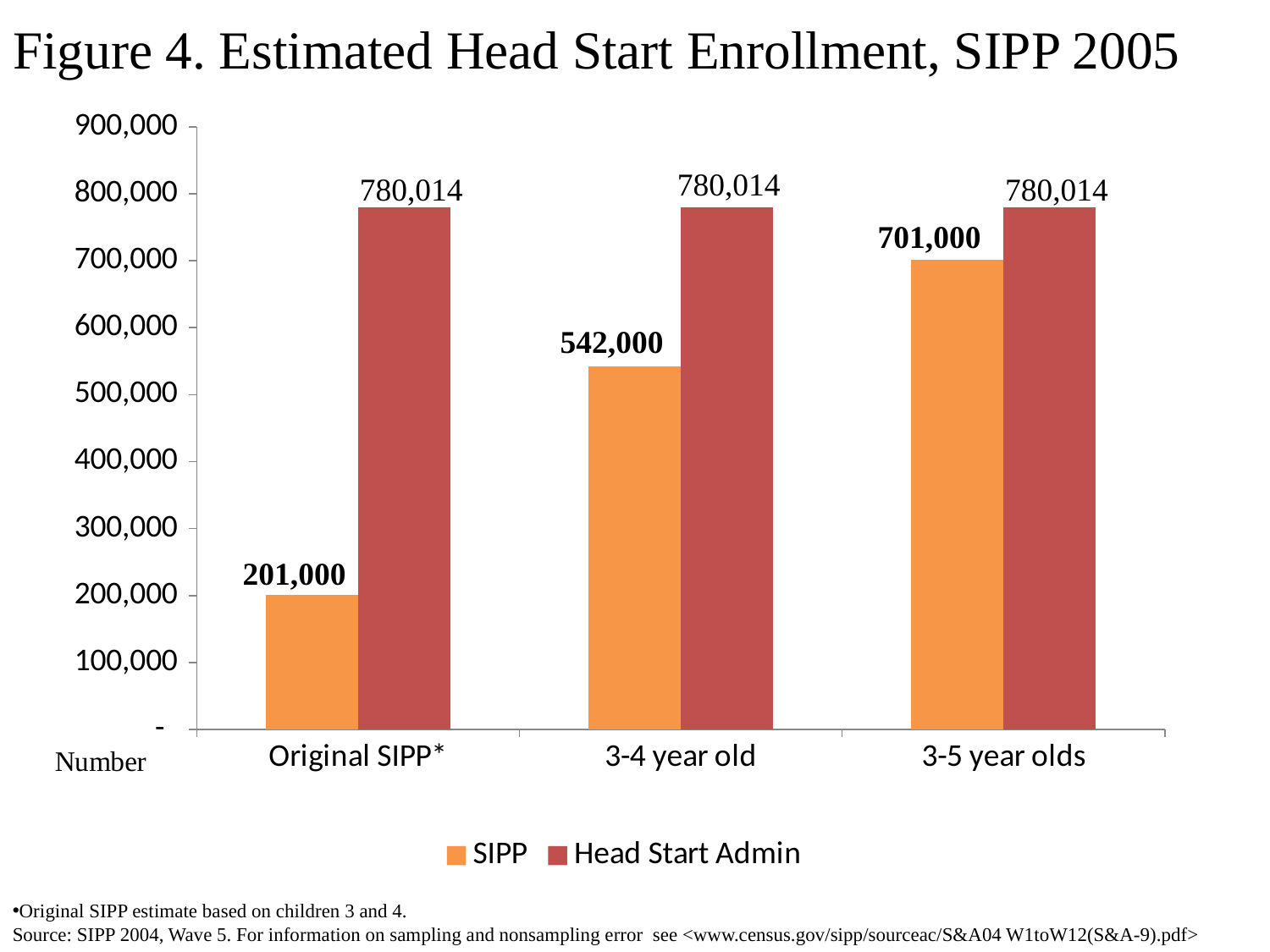
What is the SIPP value for 3-5 year olds? 701,000 What kind of chart is shown on the slide? Bar chart What is the difference between the Head Start Admin value and the SIPP value for 3-5 year olds? 79,014 Which category has the lowest SIPP value? Original SIPP* What is the SIPP value for 3-4 year old? 542,000 Which category has the highest SIPP value? 3-5 year olds What is the Head Start Admin value for 3-5 year olds? 780,014 What is the SIPP value for Original SIPP*? 201,000 How many series does the legend list? 2 What is the difference between the SIPP values for 3-4 year old and Original SIPP*? 341,000 Which is larger for 3-4 year old, the SIPP value or the Head Start Admin value? Head Start Admin How many categories are shown on the x axis? 3